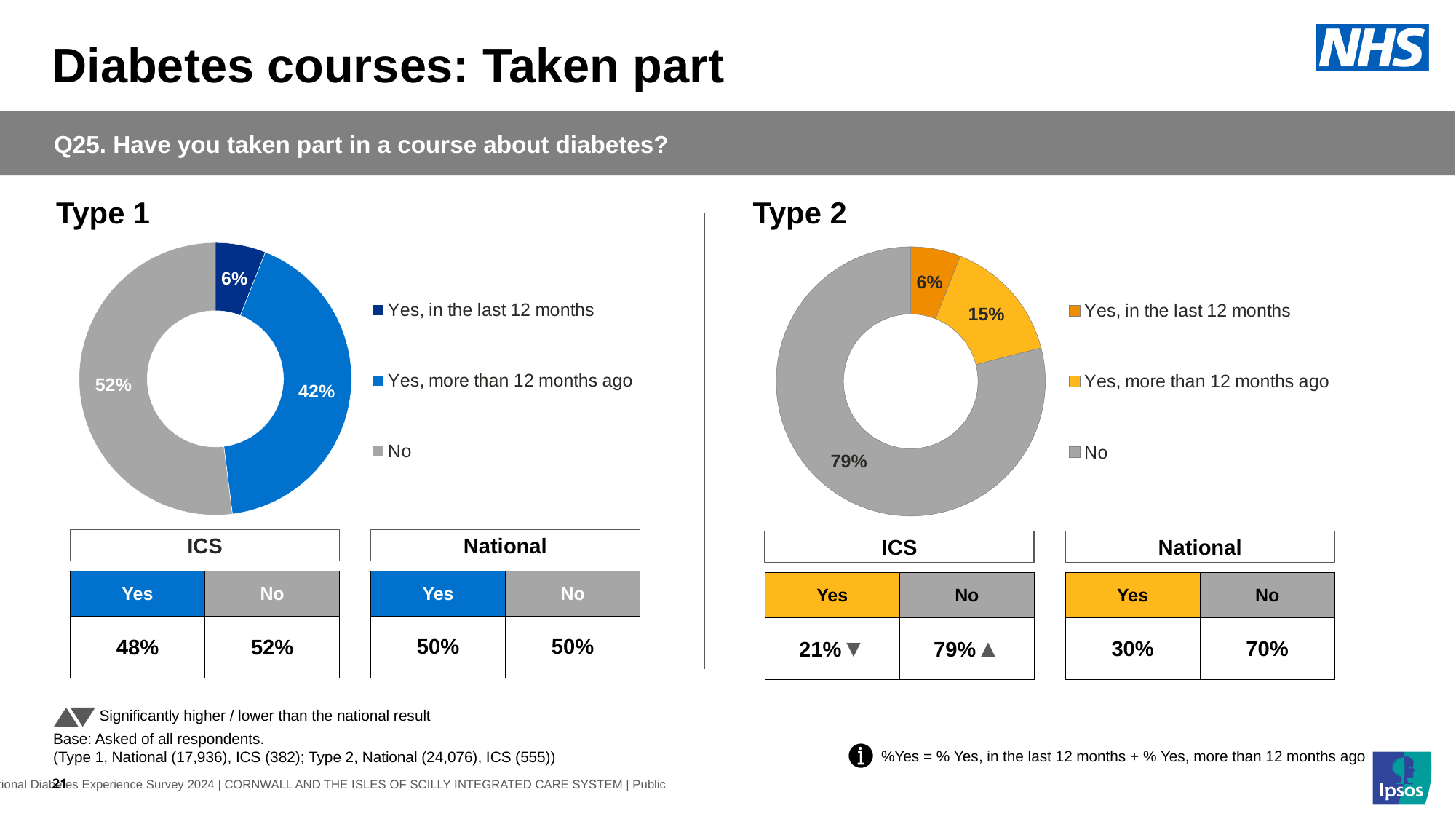
In the Type 1 chart, which category has the smallest share? Yes, in the last 12 months What kind of chart is used for Type 1? Doughnut (pie) chart What is the difference between the 'No' share in the Type 2 chart and the 'No' share in the Type 1 chart? 27 percentage points In the Type 1 chart, what percentage answered 'Yes, in the last 12 months'? 6% Which is larger in the Type 1 chart: 'Yes, more than 12 months ago' or 'No'? No In the Type 1 chart, what percentage of respondents answered 'No'? 52% In the Type 2 chart, what is the combined share of the two 'Yes' categories? 21% In the Type 2 chart, which category has the largest share? No What colour represents 'No' in both charts? Grey What colour represents 'Yes, in the last 12 months' in the Type 2 chart? Orange In the Type 2 chart, what percentage answered 'Yes, more than 12 months ago'? 15% How many categories does the Type 2 chart's legend list? 3